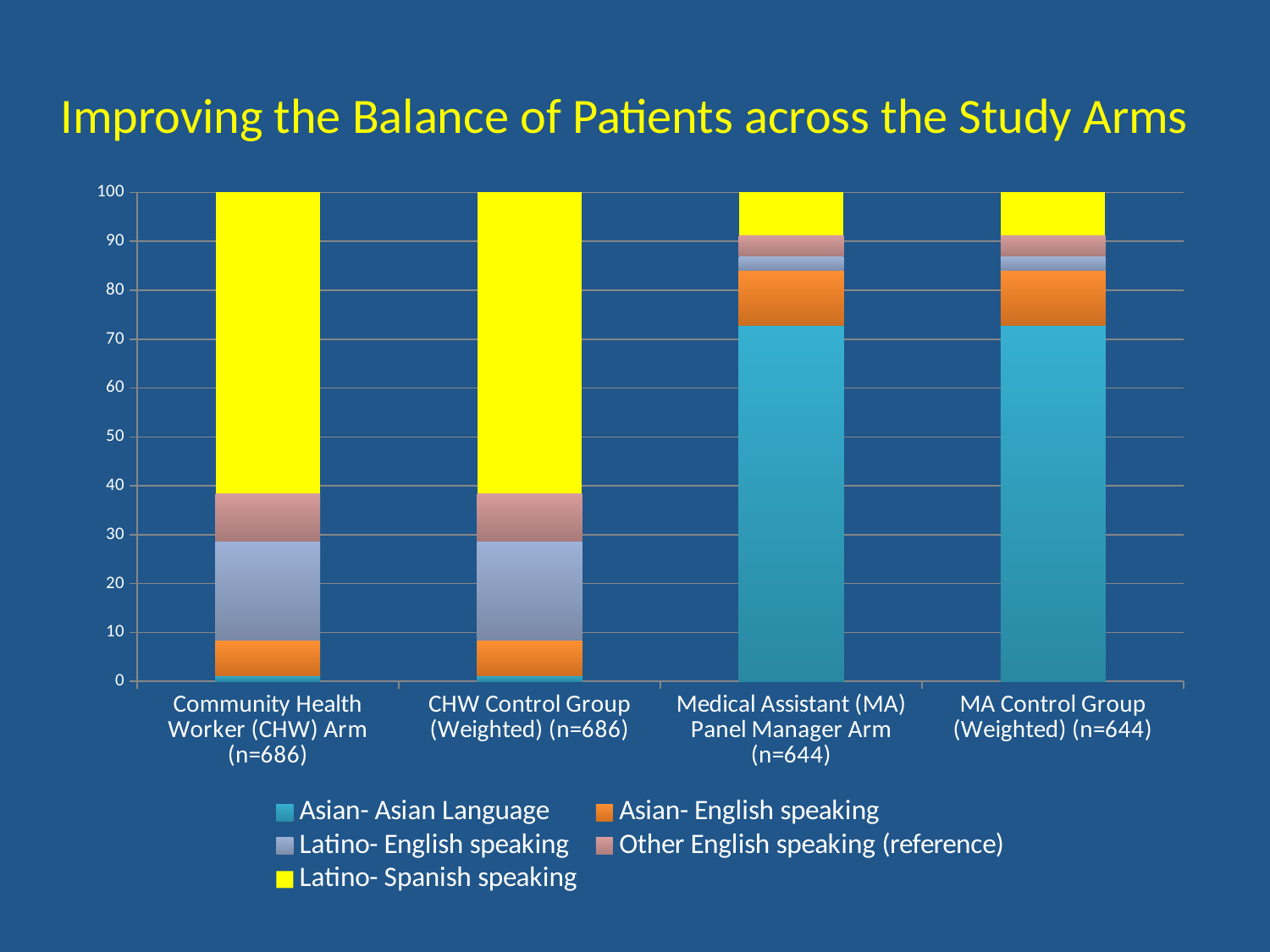
Which study arm has the larger Latino- Spanish speaking segment: CHW Control Group (Weighted) (n=686) or Medical Assistant (MA) Panel Manager Arm (n=644)? CHW Control Group (Weighted) (n=686) What is the title of the chart? Improving the Balance of Patients across the Study Arms Is the Asian- Asian Language segment for Community Health Worker (CHW) Arm (n=686) greater or less than 10? less What is the total height of the stacked bar for Community Health Worker (CHW) Arm (n=686)? 100 Which legend entry is shown in yellow? Latino- Spanish speaking What kind of chart is shown on the slide? stacked bar chart How many study arms (categories) are shown on the x axis? 4 Is the Latino- Spanish speaking segment for MA Control Group (Weighted) (n=644) greater or less than 20? less How many series does the legend list? 5 Which study arm has the larger Asian- Asian Language segment: Community Health Worker (CHW) Arm (n=686) or MA Control Group (Weighted) (n=644)? MA Control Group (Weighted) (n=644) Is the Latino- Spanish speaking segment for Community Health Worker (CHW) Arm (n=686) greater or less than 50? greater